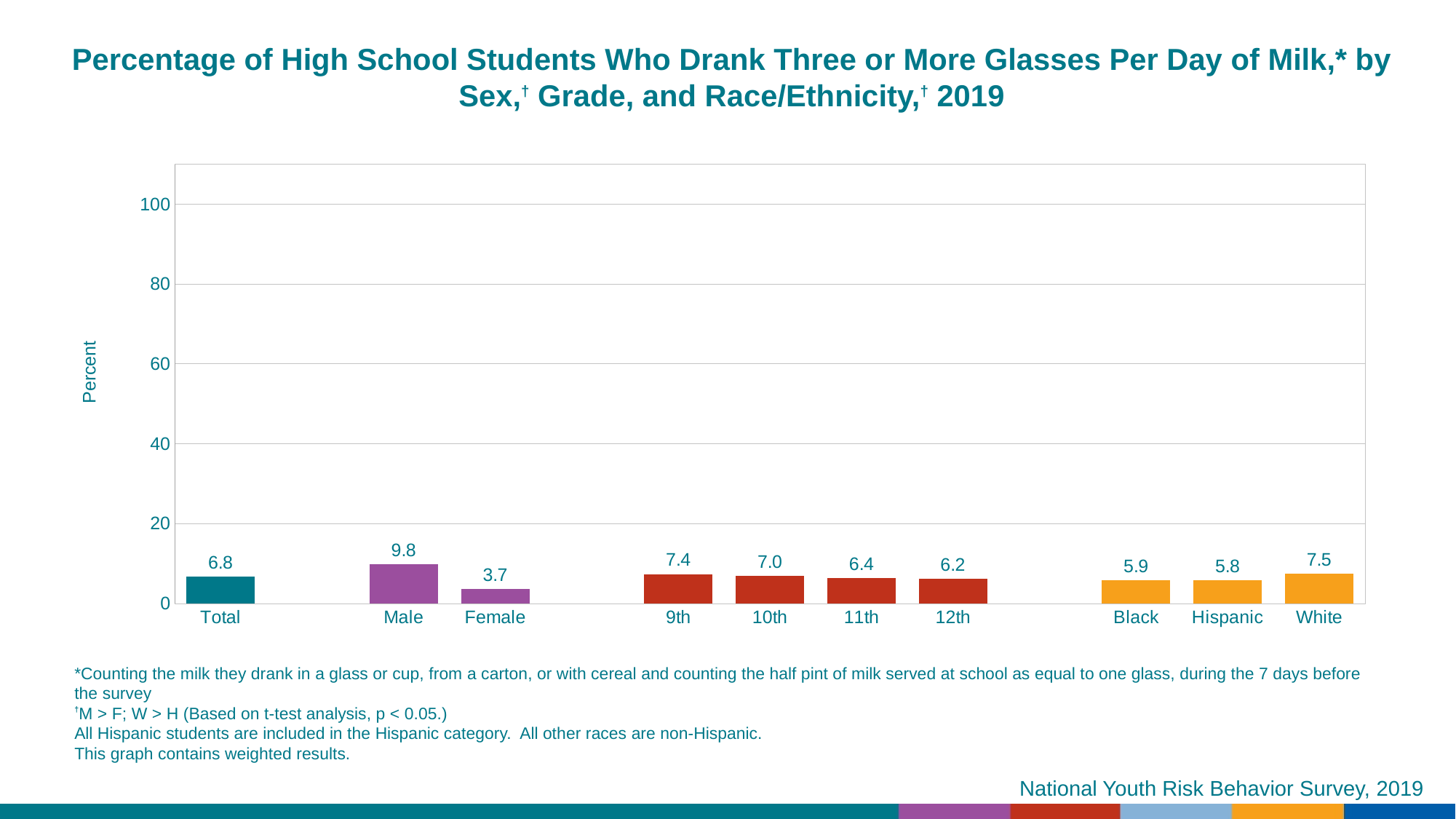
What is the value for Hispanic students? 5.8 What is the value for Male? 9.8 Which category has the lowest value? Female How many categories are shown on the x axis? 10 What kind of chart is this? bar chart What is the value for 11th grade? 6.4 Which is larger, the value for 9th grade or the value for 12th grade? 9th What is the value for Female? 3.7 Which category has the highest value? Male Do the values rise or fall from 9th grade to 12th grade? fall Is the value for Total greater or less than 20? less What is the difference between the Male and Female values? 6.1